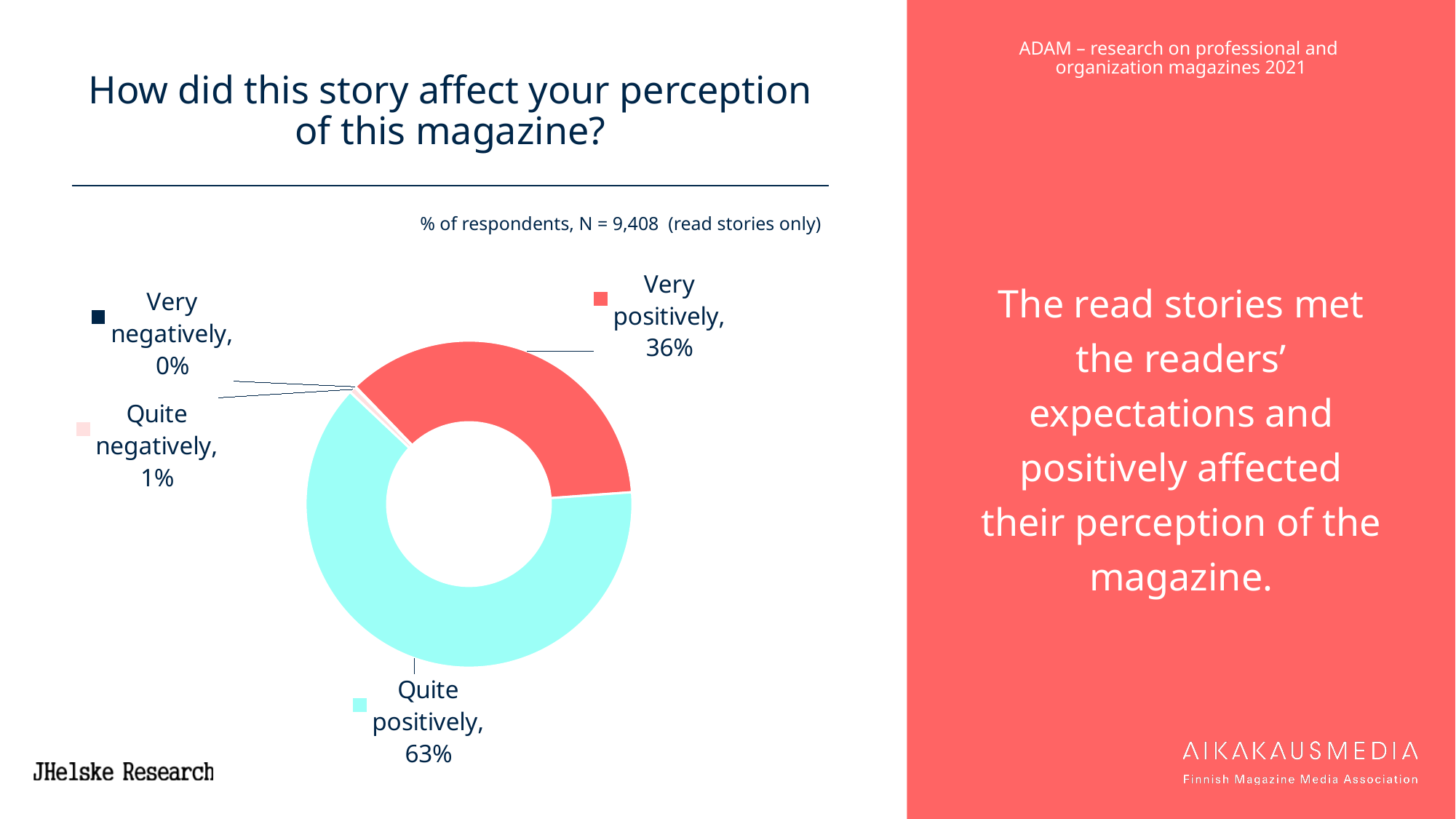
Which response category has the smallest share of respondents? Very negatively What percentage of respondents answered 'Quite positively'? 63% Which response category has the largest share of respondents? Quite positively What is the combined share of respondents who answered 'Very positively' or 'Quite positively'? 99% What percentage of respondents answered 'Very negatively'? 0% Which is larger: the share for 'Very positively' or the share for 'Quite positively'? Quite positively What kind of chart is used on this slide? Doughnut chart How many response categories are shown in the chart? 4 What is the difference in percentage points between 'Quite positively' and 'Very positively'? 27 What percentage of respondents answered 'Quite negatively'? 1% How many respondents (N) does the chart subtitle say the data is based on? 9,408 What percentage of respondents said the story affected their perception of the magazine very positively? 36%